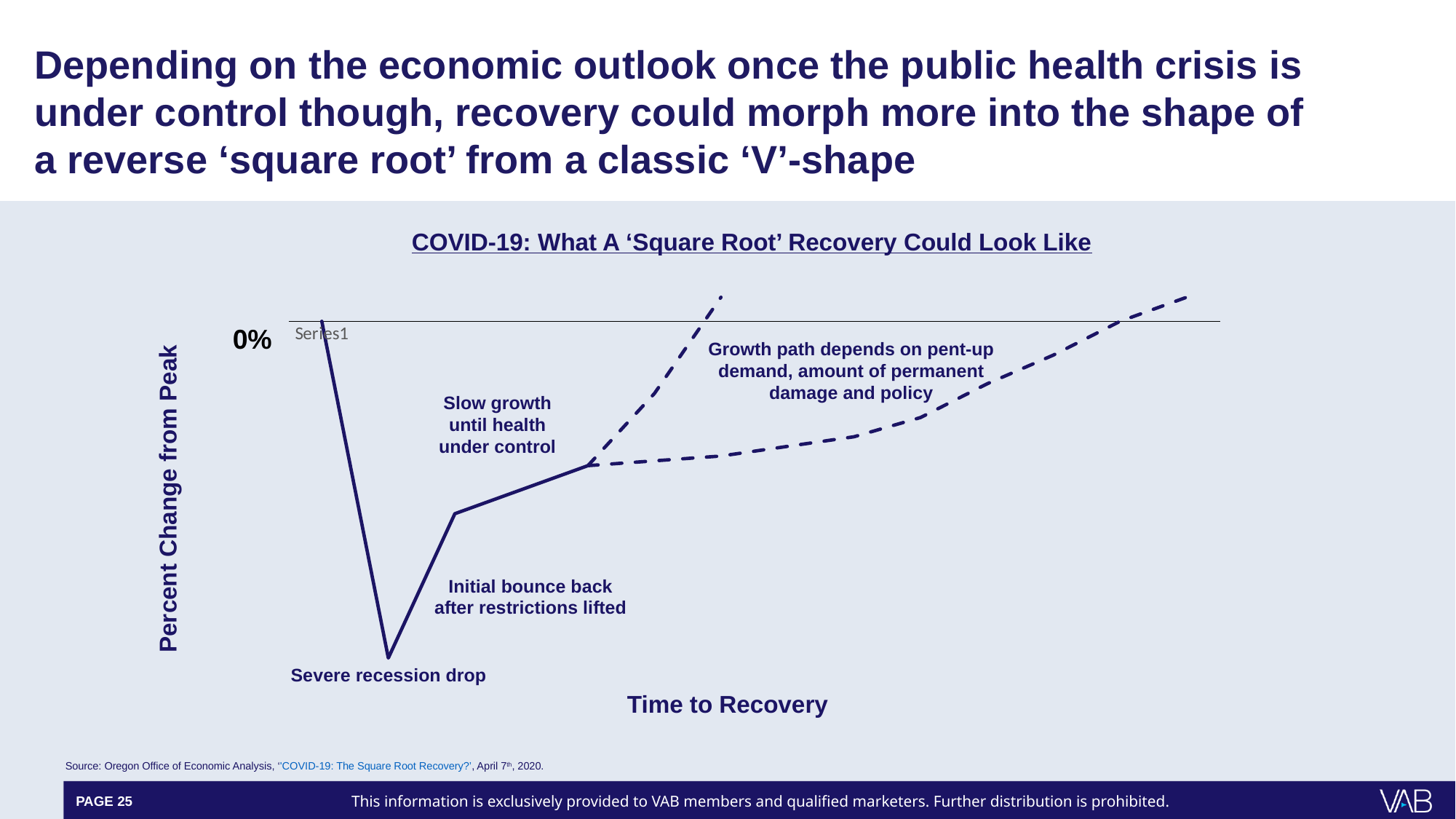
How many dashed growth paths branch off from the end of the solid line? 2 What is the label on the vertical axis of the chart? Percent Change from Peak After the point labelled 'Severe recession drop', does the solid line rise or fall? rise Which labelled point on the line is the lowest? Severe recession drop What is the title of the chart? COVID-19: What A 'Square Root' Recovery Could Look Like What kind of chart is shown on the slide? line chart Is the value at the 'Severe recession drop' point greater or less than 0%? less Starting from the 0% line, does the solid line initially rise or fall? fall Is the point at the end of the 'Initial bounce back after restrictions lifted' segment higher or lower than the 'Severe recession drop' point? higher Does the upper dashed growth path end above or below the 0% line? above